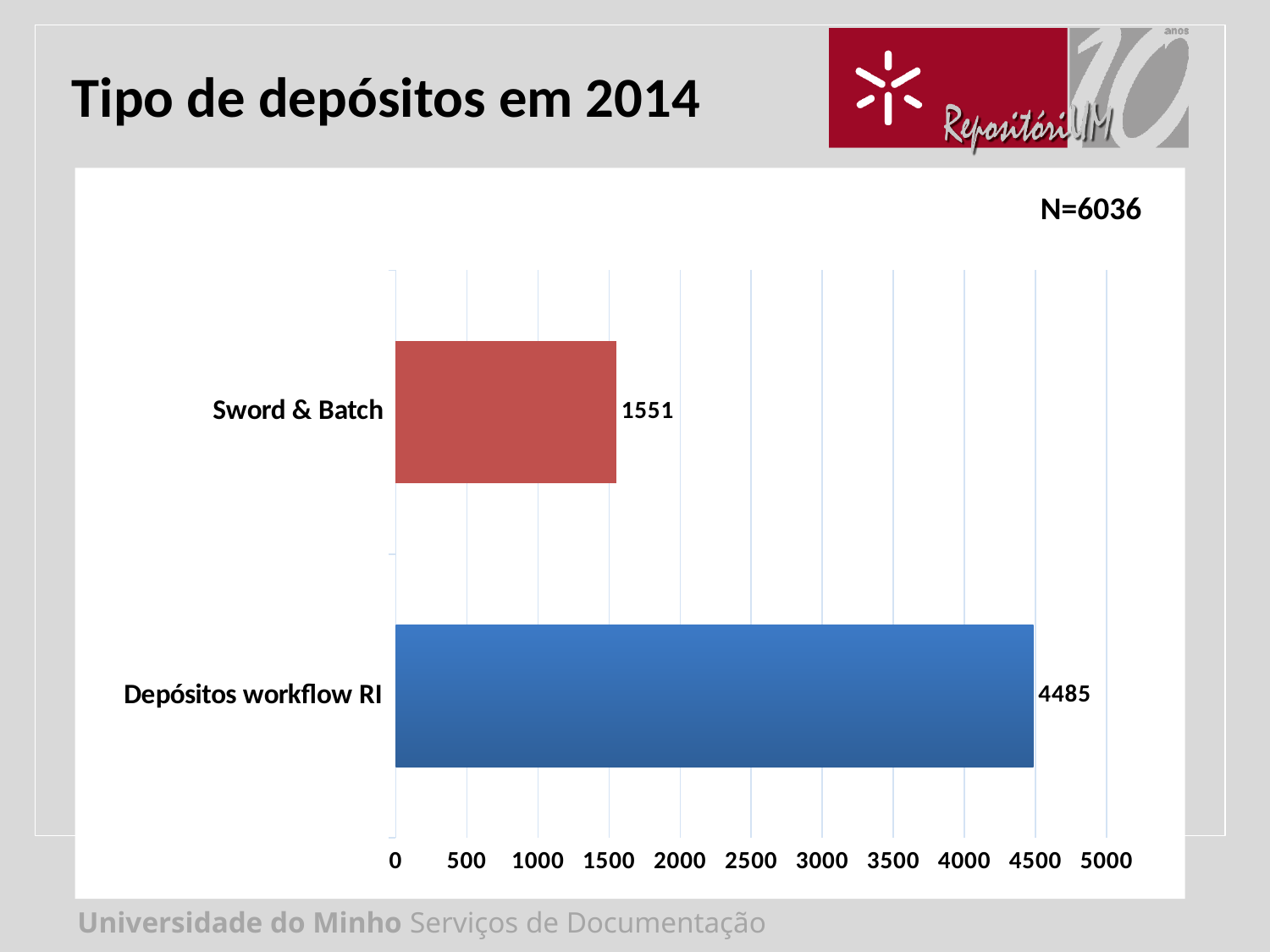
What is the value for Depósitos workflow RI? 4485 What kind of chart is shown on the slide? bar chart Which category has the highest value? Depósitos workflow RI What is the value for Sword & Batch? 1551 Is the value for Depósitos workflow RI greater or less than 4000? greater How many categories are shown in the chart? 2 Which category has the lowest value? Sword & Batch What is the difference between the values for Depósitos workflow RI and Sword & Batch? 2934 What is the total of the two values shown in the chart? 6036 Is the value for Sword & Batch greater or less than 2000? less Which is larger, the value for Sword & Batch or the value for Depósitos workflow RI? Depósitos workflow RI What is the title of the slide? Tipo de depósitos em 2014